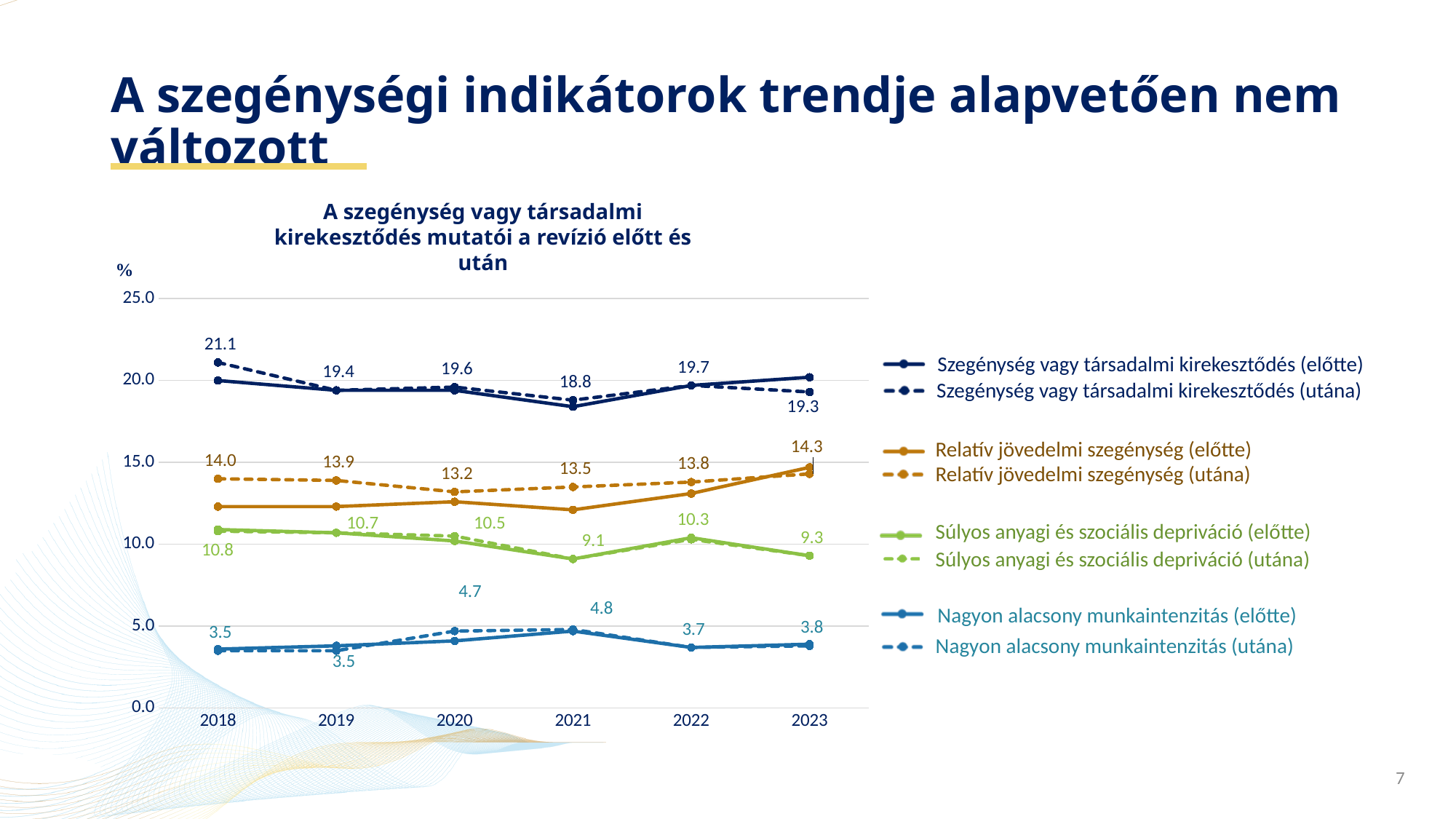
What is the value of Szegénység vagy társadalmi kirekesztődés (utána) in 2018? 21.1 In which year is Szegénység vagy társadalmi kirekesztődés (utána) highest? 2018 How many series does the legend list? 8 What is the difference between the 2023 and 2020 values of Relatív jövedelmi szegénység (utána)? 1.1 What kind of chart is shown on the slide? line chart How many years are shown on the x axis? 6 What is the value of Nagyon alacsony munkaintenzitás (utána) in 2020? 4.7 What unit is shown on the y axis? % What is the value of Relatív jövedelmi szegénység (utána) in 2023? 14.3 In which year is Súlyos anyagi és szociális depriváció (utána) lowest? 2021 What is the value of Súlyos anyagi és szociális depriváció (utána) in 2021? 9.1 Is the value for Relatív jövedelmi szegénység (előtte) in 2018 greater or less than 15.0? less